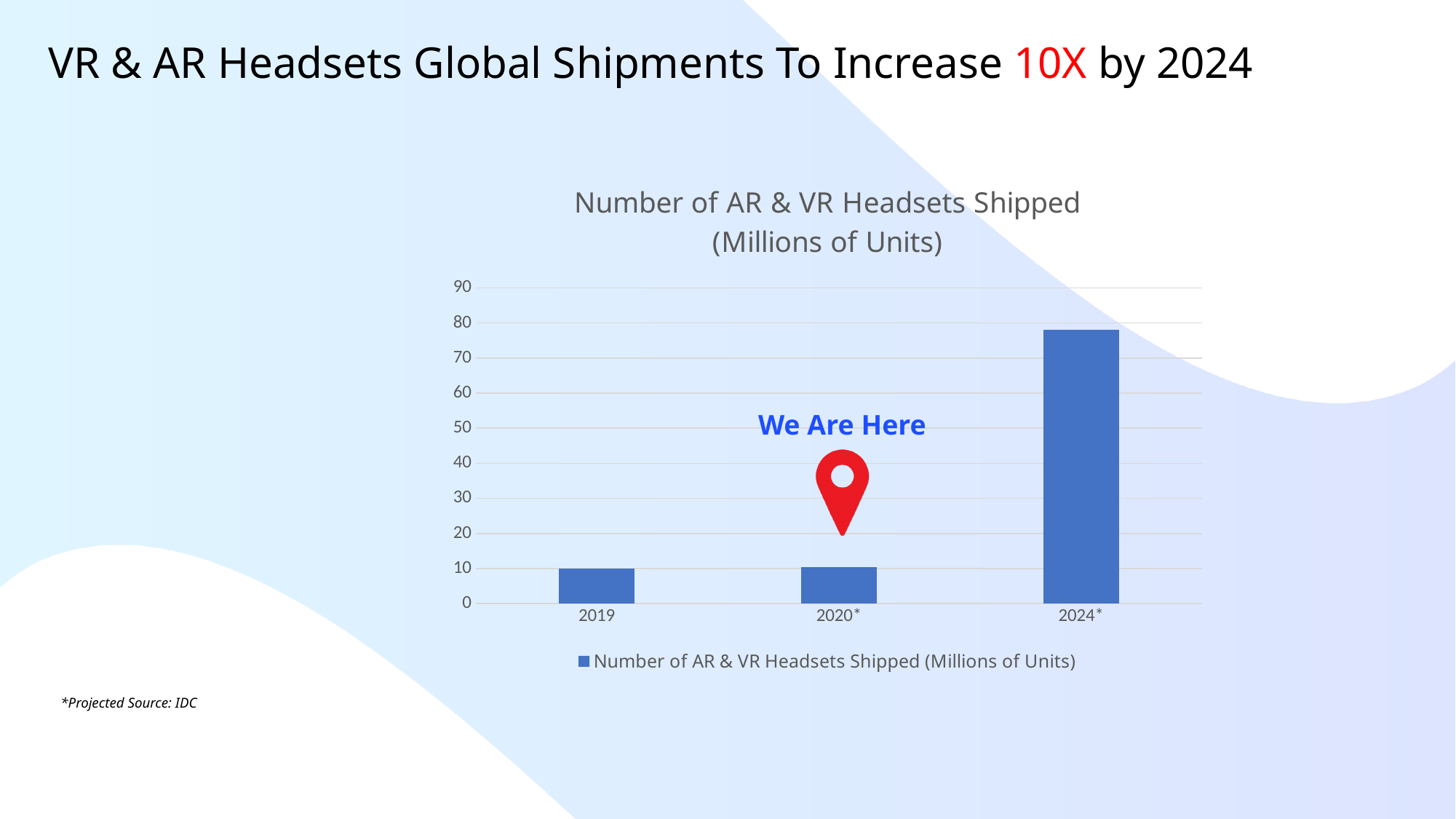
Is the value for 2024* greater or less than 70? greater Which year has the highest number of AR & VR headsets shipped? 2024* Is the value for 2019 greater or less than 20? less How many series does the chart's legend list? 1 Is the value for 2024* greater or less than 80? less How many categories (years) are shown on the x axis of the chart? 3 Do the values rise or fall from 2019 to 2024* along the x axis? Rise What is the title of the chart? Number of AR & VR Headsets Shipped (Millions of Units) What kind of chart is shown on the slide? Bar chart Which is larger, the value for 2024* or the value for 2019? 2024* What label is shown in the chart's legend? Number of AR & VR Headsets Shipped (Millions of Units)